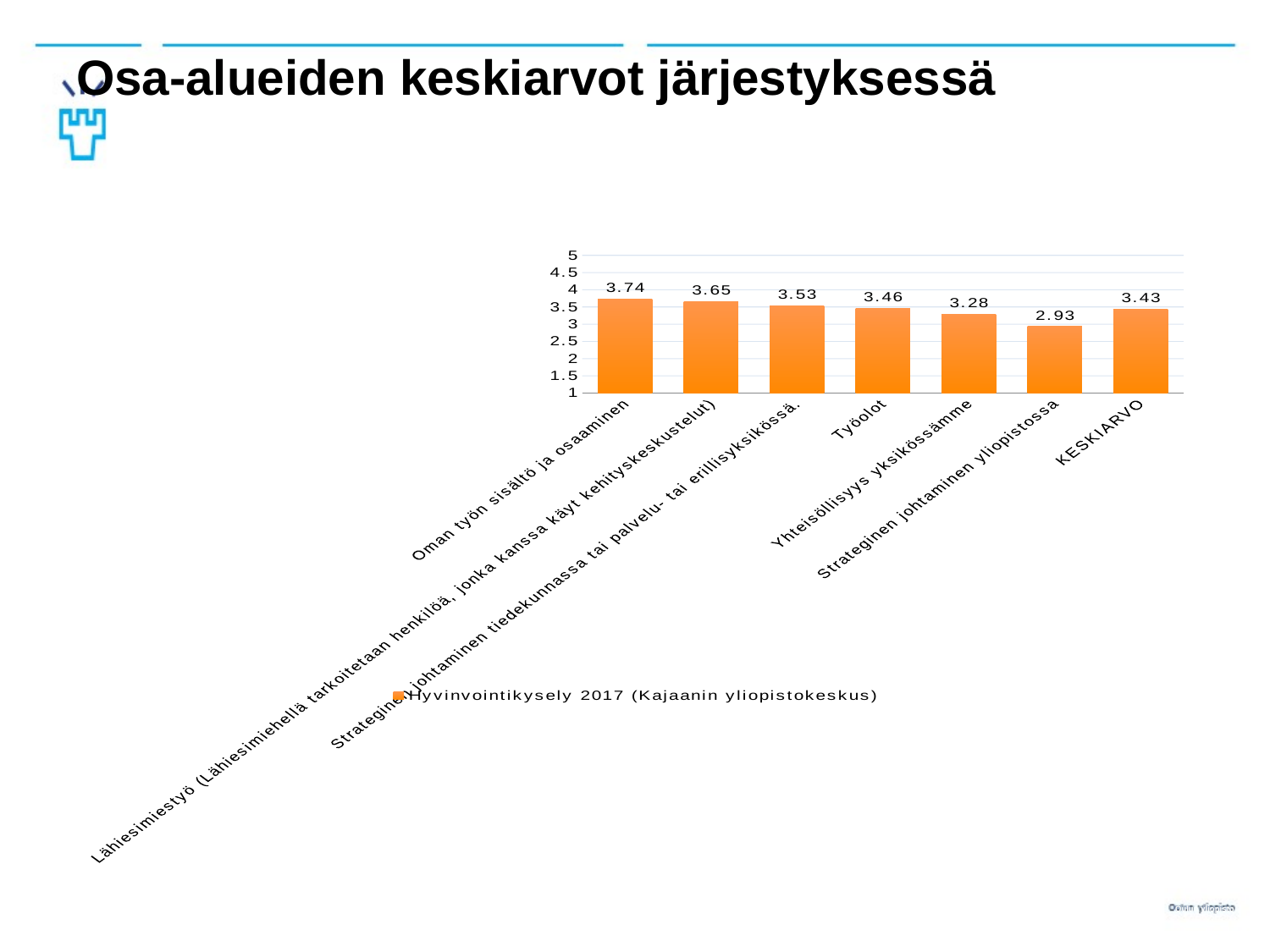
What is the value for Strateginen johtaminen yliopistossa? 2.93 What is the legend entry of the chart? Hyvinvointikysely 2017 (Kajaanin yliopistokeskus) What is the value for Työolot? 3.46 What is the value for Yhteisöllisyys yksikössämme? 3.28 Is the value for Strateginen johtaminen yliopistossa greater or less than 3? less What is the value for KESKIARVO? 3.43 Which category has the highest value? Oman työn sisältö ja osaaminen How many bars are shown in the chart? 7 Which category has the lowest value? Strateginen johtaminen yliopistossa What kind of chart is shown on the slide? bar chart What is the difference between the values for Oman työn sisältö ja osaaminen and Strateginen johtaminen yliopistossa? 0.81 Which is larger, the value for Työolot or the value for Yhteisöllisyys yksikössämme? Työolot